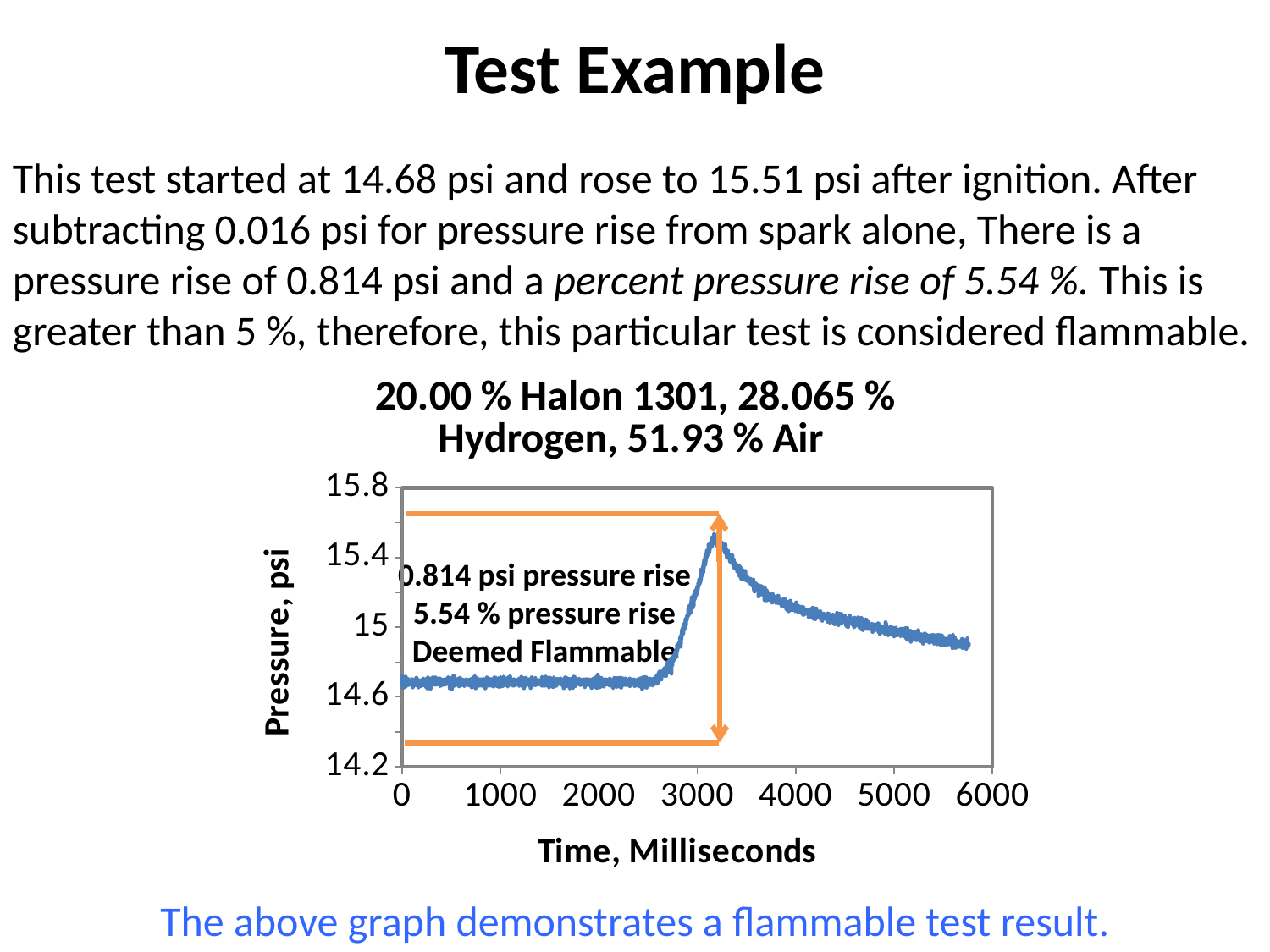
According to the annotation on the chart, what is the pressure rise in psi? 0.814 psi Is the pressure at 1000 milliseconds greater or less than 14.6? greater What is the title of the chart? 20.00 % Halon 1301, 28.065 % Hydrogen, 51.93 % Air What is the label of the y axis of the chart? Pressure, psi Is the pressure at time 0 greater or less than 15? less According to the annotation on the chart, what is the percent pressure rise? 5.54 % What is the highest value shown on the y axis of the chart? 15.8 After reaching its peak, does the pressure rise or fall as time increases? fall Between 0 and 2000 milliseconds, does the pressure rise sharply, fall sharply, or stay roughly flat? stay roughly flat Is the peak pressure value on the chart greater or less than 15.4? greater What kind of chart is shown on the slide? line chart